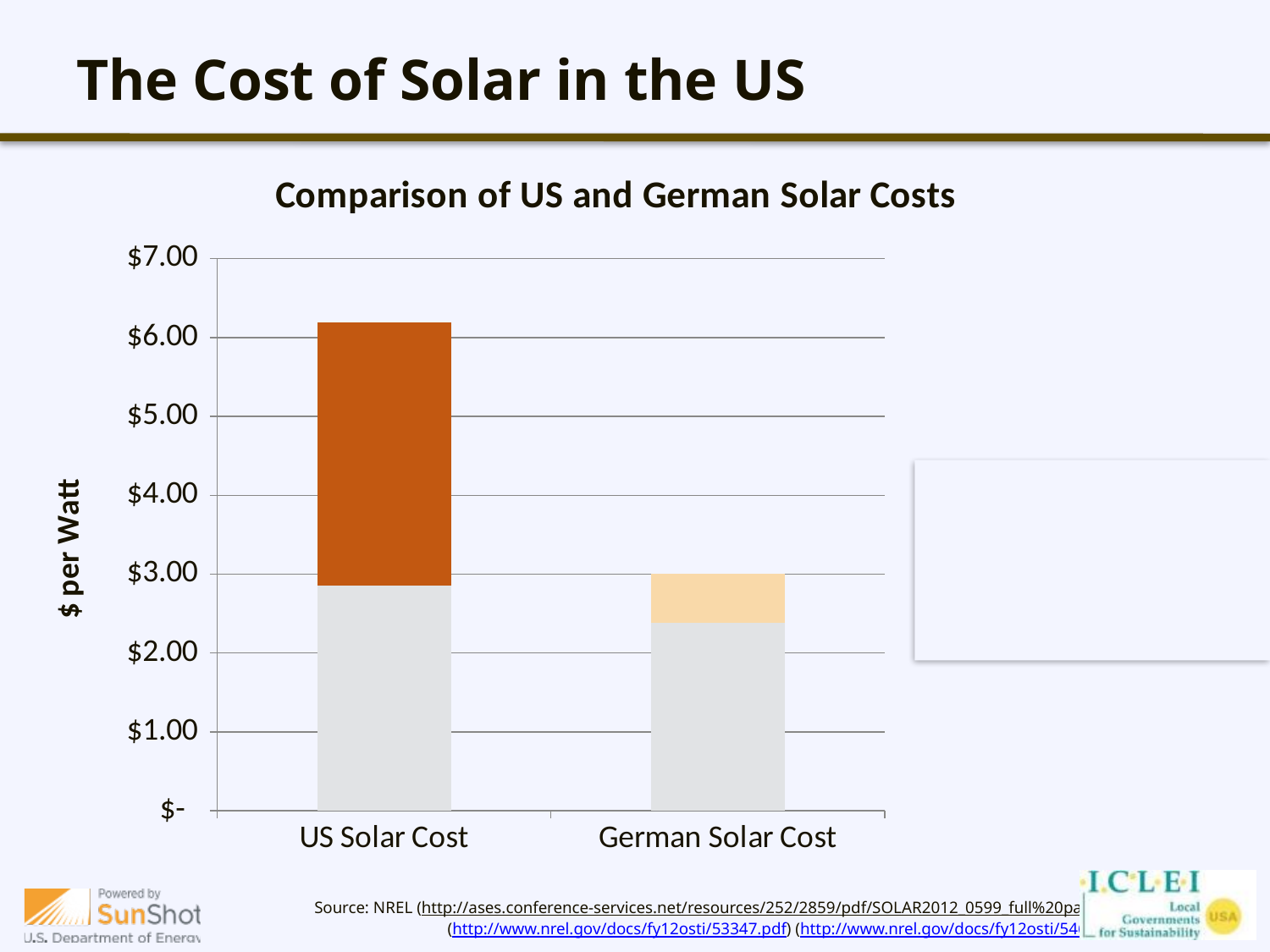
Which is larger, the total bar for US Solar Cost or for German Solar Cost? US Solar Cost What kind of chart is shown on the slide? bar chart Which category has the highest total bar in the chart? US Solar Cost Is the total value for German Solar Cost greater or less than $2.00? greater What is the title of the chart? Comparison of US and German Solar Costs Is the total value for US Solar Cost greater or less than $7.00? less Is the lower (grey) segment of the US Solar Cost bar greater or less than $2.00? greater Which category has the lowest total bar in the chart? German Solar Cost What is the label on the vertical axis of the chart? $ per Watt How many categories are shown on the x axis of the chart? 2